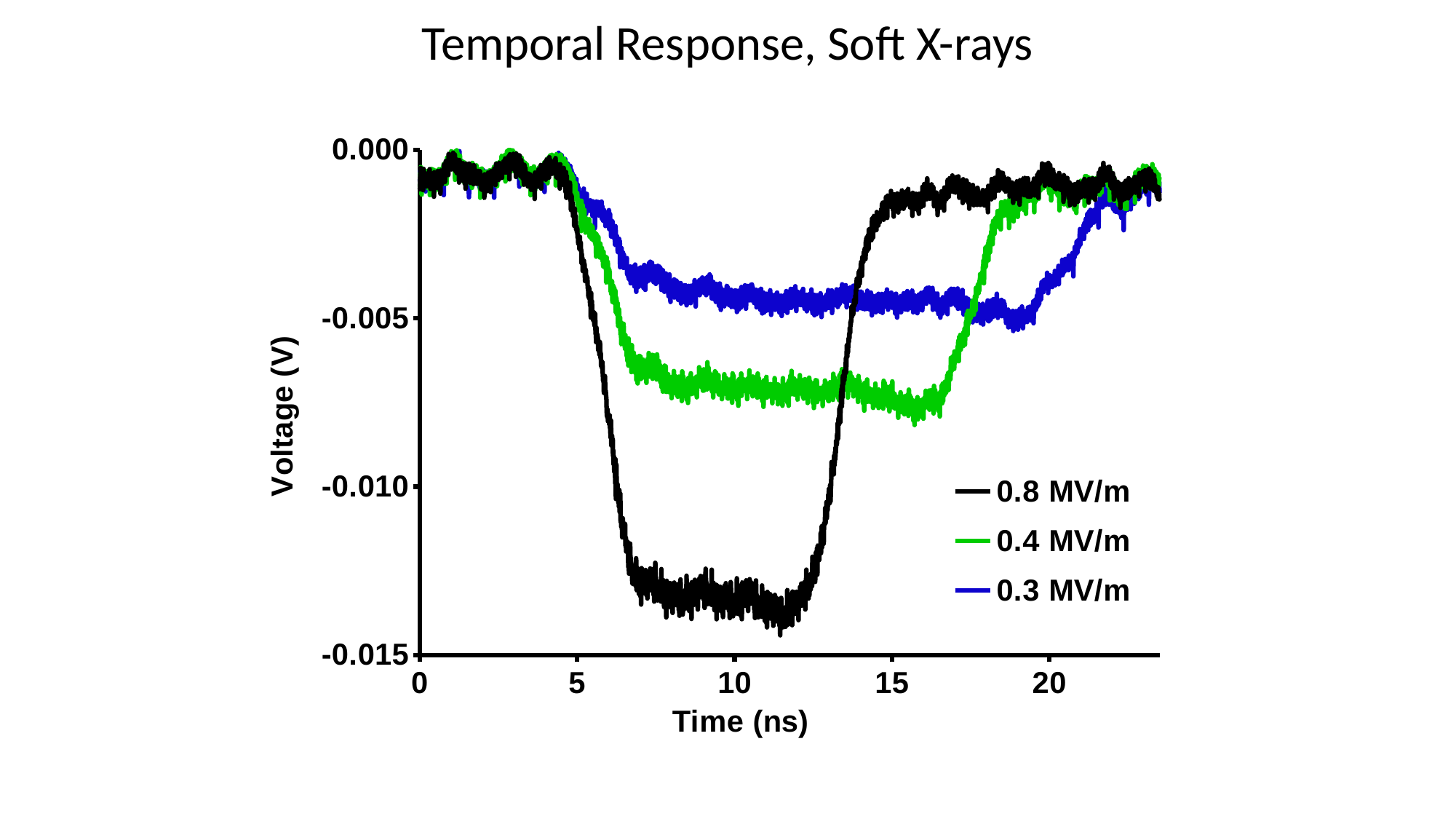
Does the 0.8 MV/m trace rise or fall between 5 ns and 7 ns? fall Is the plateau voltage of the 0.4 MV/m trace around 10 ns greater or less than -0.005? less Which series has the smallest voltage dip? 0.3 MV/m Which series returns to its baseline voltage last? 0.3 MV/m Is the minimum voltage of the 0.8 MV/m trace greater or less than -0.010? less How many series does the legend list? 3 What is the title of the chart? Temporal Response, Soft X-rays Which series returns to its baseline voltage first, 0.8 MV/m or 0.3 MV/m? 0.8 MV/m Is the plateau voltage of the 0.3 MV/m trace around 10 ns greater or less than -0.005? greater What kind of chart is shown on the slide? line chart What is the label of the y axis? Voltage (V) Which series reaches the lowest voltage? 0.8 MV/m